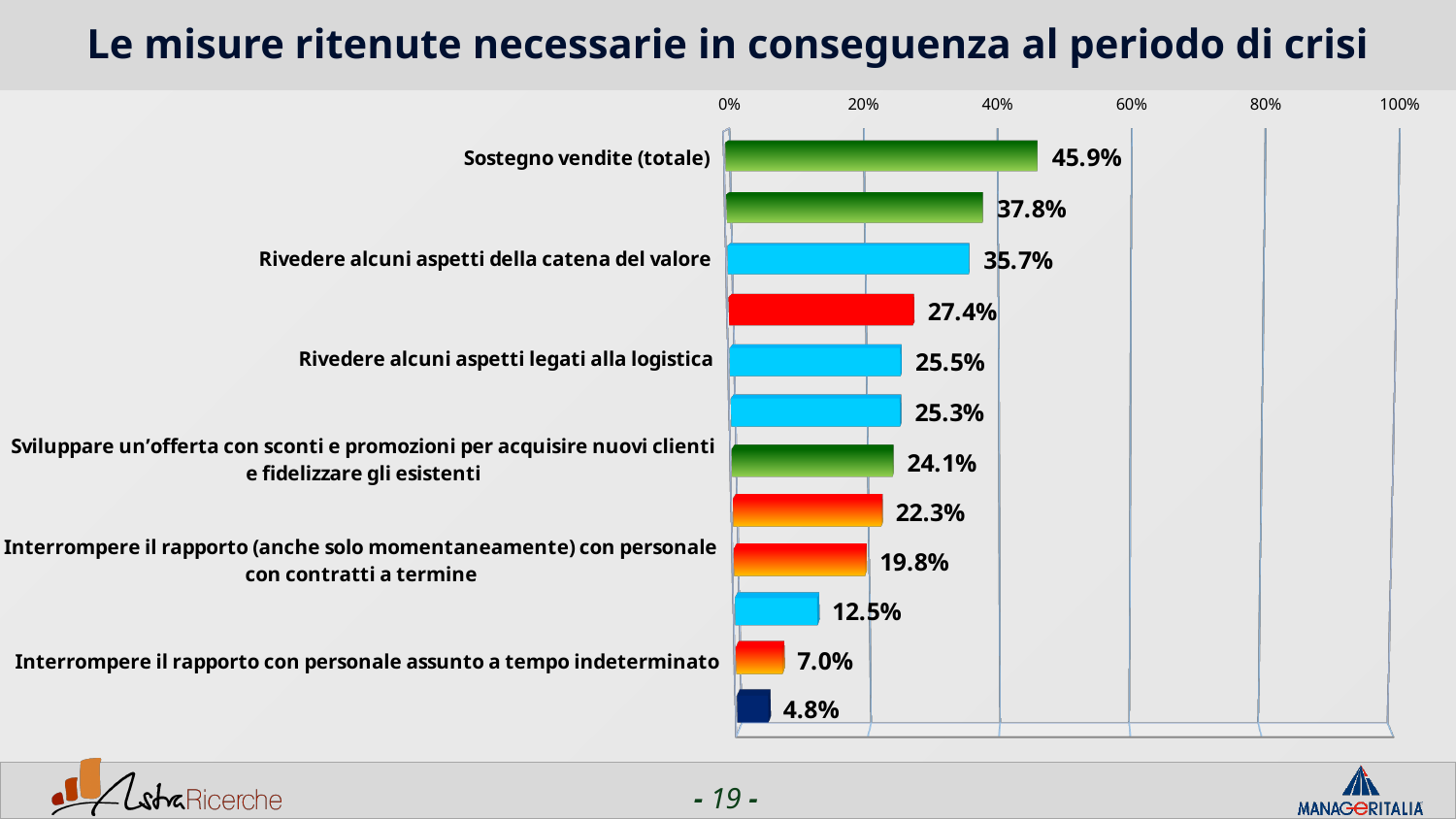
What is the value for "Sostegno vendite (totale)"? 45.9% What is the title of the slide? Le misure ritenute necessarie in conseguenza al periodo di crisi Which category has the highest value? Sostegno vendite (totale) Is the value for "Sostegno vendite (totale)" greater or less than 40%? greater What kind of chart is shown on the slide? Bar chart How many bars are plotted on the chart? 12 Which is larger: "Rivedere alcuni aspetti legati alla logistica" or "Interrompere il rapporto (anche solo momentaneamente) con personale con contratti a termine"? Rivedere alcuni aspetti legati alla logistica What is the difference between "Sostegno vendite (totale)" and "Rivedere alcuni aspetti della catena del valore"? 10.2 percentage points What is the value for "Interrompere il rapporto con personale assunto a tempo indeterminato"? 7.0% What is the value for "Rivedere alcuni aspetti legati alla logistica"? 25.5% What is the value for "Rivedere alcuni aspetti della catena del valore"? 35.7% What is the lowest value shown on the chart? 4.8%